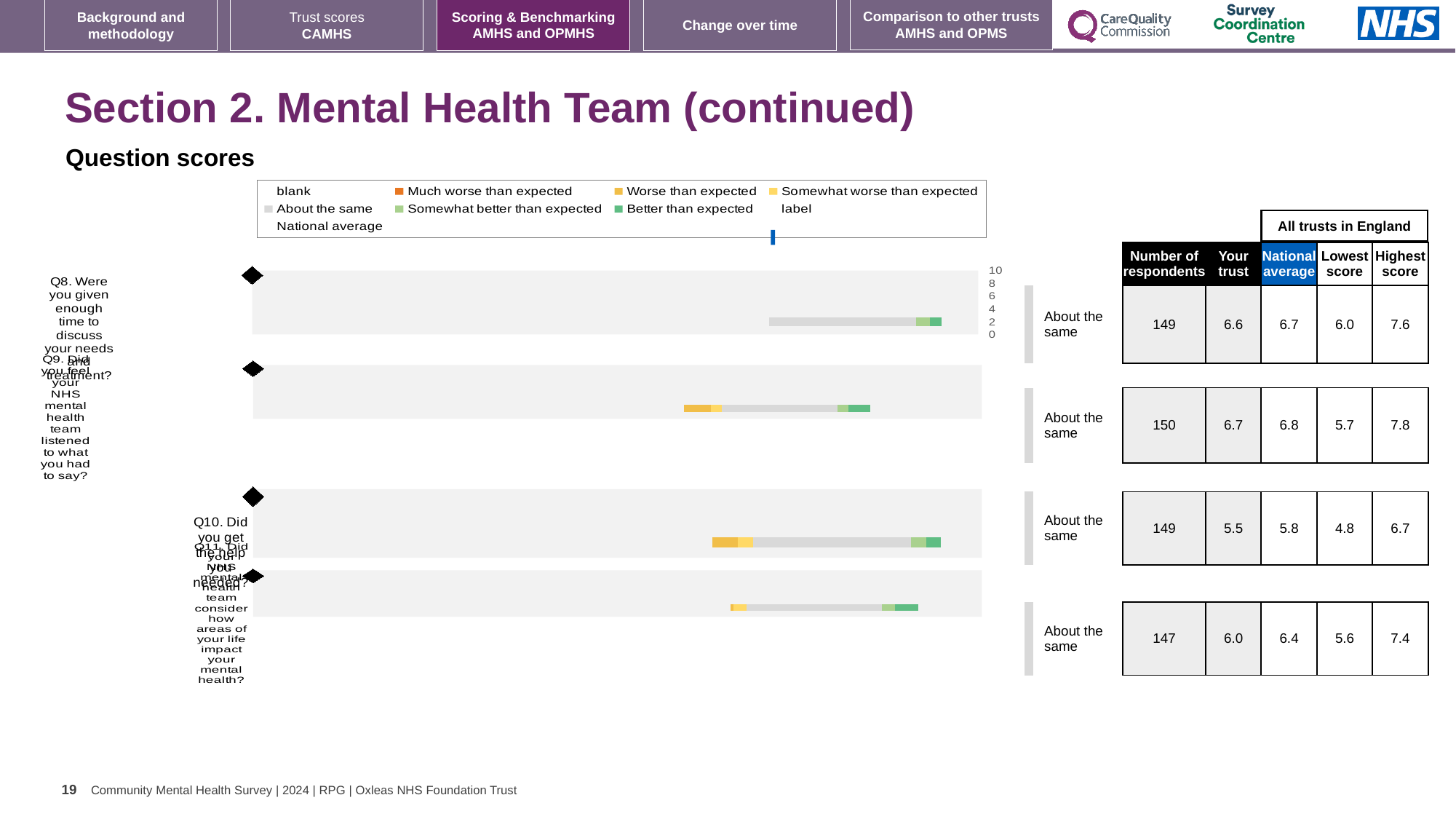
In the table beside the chart, what is the difference between the highest score and the lowest score for Q9? 2.1 Which question has the highest 'Your trust' score in the table beside the chart? Q9 Which colour does the legend use for 'Much worse than expected'? orange Which question has the lowest 'Your trust' score in the table beside the chart? Q10 Which colour does the legend use for 'Better than expected'? green In the table beside the chart, what is the 'Your trust' score for Q8? 6.6 What benchmark category is shown for all four questions on this slide? About the same What kind of chart is used to show the question scores on this slide? bar chart In the table beside the chart, what is the national average for Q10? 5.8 In the table beside the chart, how many respondents answered Q11? 147 For Q8, which is larger in the table beside the chart: the 'Your trust' score or the national average? National average How many questions (categories) are plotted in the question scores chart? 4